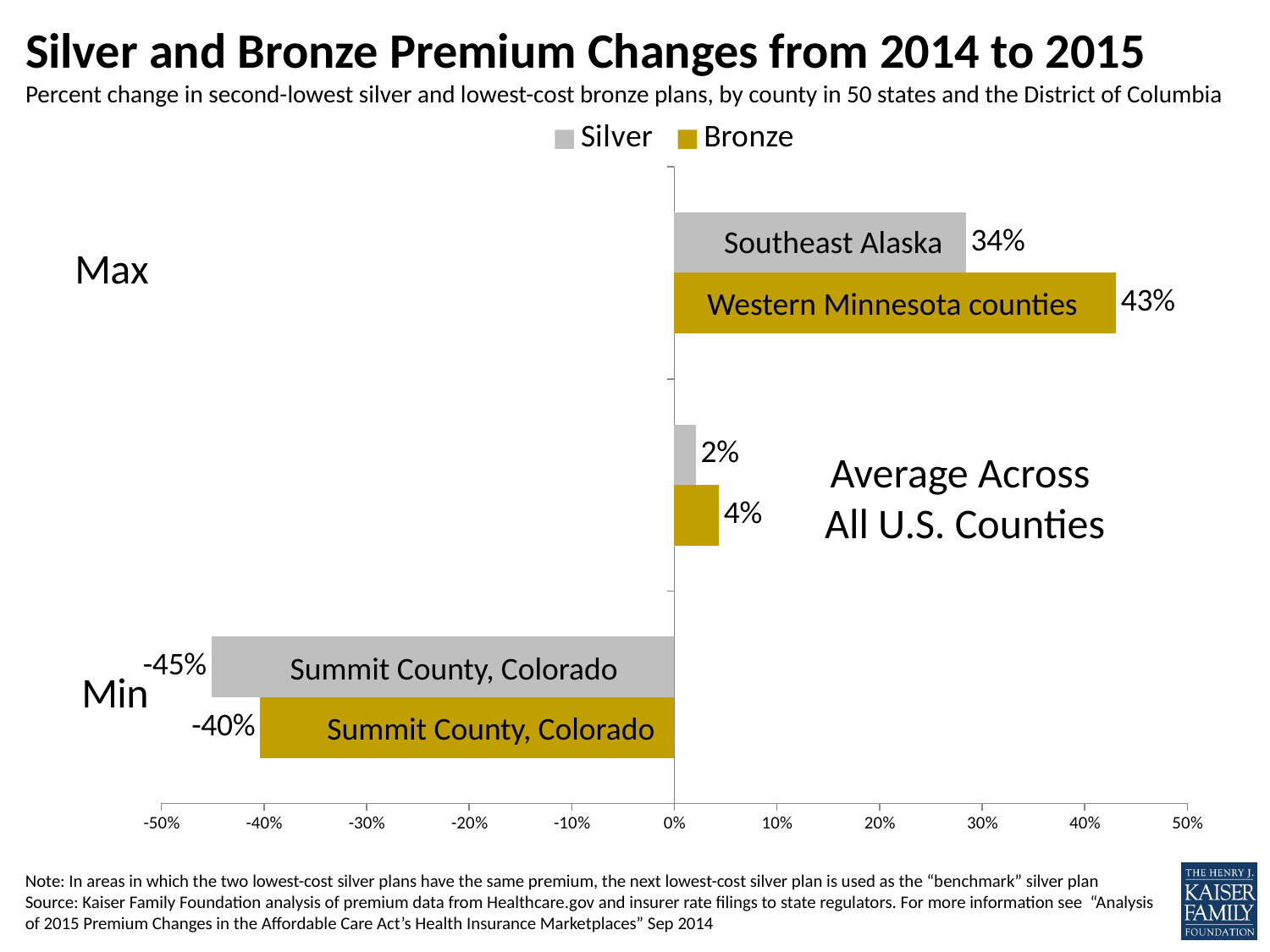
What is the Silver value for Min? -45% Which category has the highest Bronze value? Max What is the Silver value for Max? 34% How many series does the legend list? 2 What kind of chart is shown on the slide? Bar chart What is the Silver value for Average Across All U.S. Counties? 2% What is the Bronze value for Average Across All U.S. Counties? 4% Which is larger for Min, the Silver value or the Bronze value? Bronze Which category has the lowest Silver value? Min What is the Bronze value for Min? -40% What is the Bronze value for Max? 43% What is the difference between the Bronze and Silver values for Max? 9%